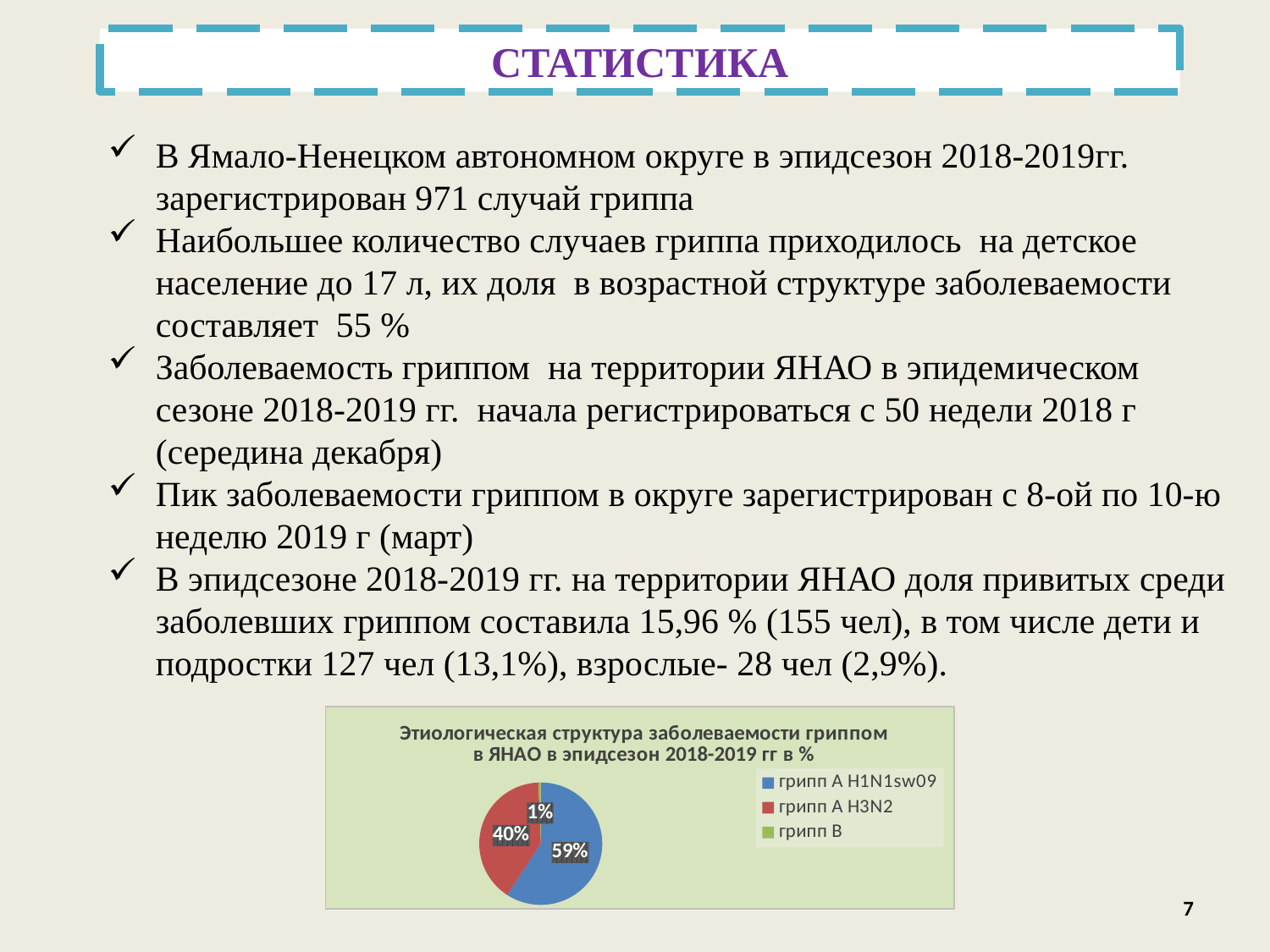
What share of the pie does грипп В have? 1% What is the difference in percentage points between грипп А H1N1sw09 and грипп А H3N2? 19 Which category has the largest slice of the pie? грипп А H1N1sw09 What kind of chart is shown on the slide? pie chart What share of the pie does грипп А H3N2 have? 40% How many slices does the pie chart have? 3 What colour is the slice for грипп А H3N2? red Which is larger, the share for грипп А H3N2 or the share for грипп В? грипп А H3N2 What share of the pie does грипп А H1N1sw09 have? 59% What is the title of the chart? Этиологическая структура заболеваемости гриппом в ЯНАО в эпидсезон 2018-2019 гг в % How many entries does the legend list? 3 Which category has the smallest slice of the pie? грипп В